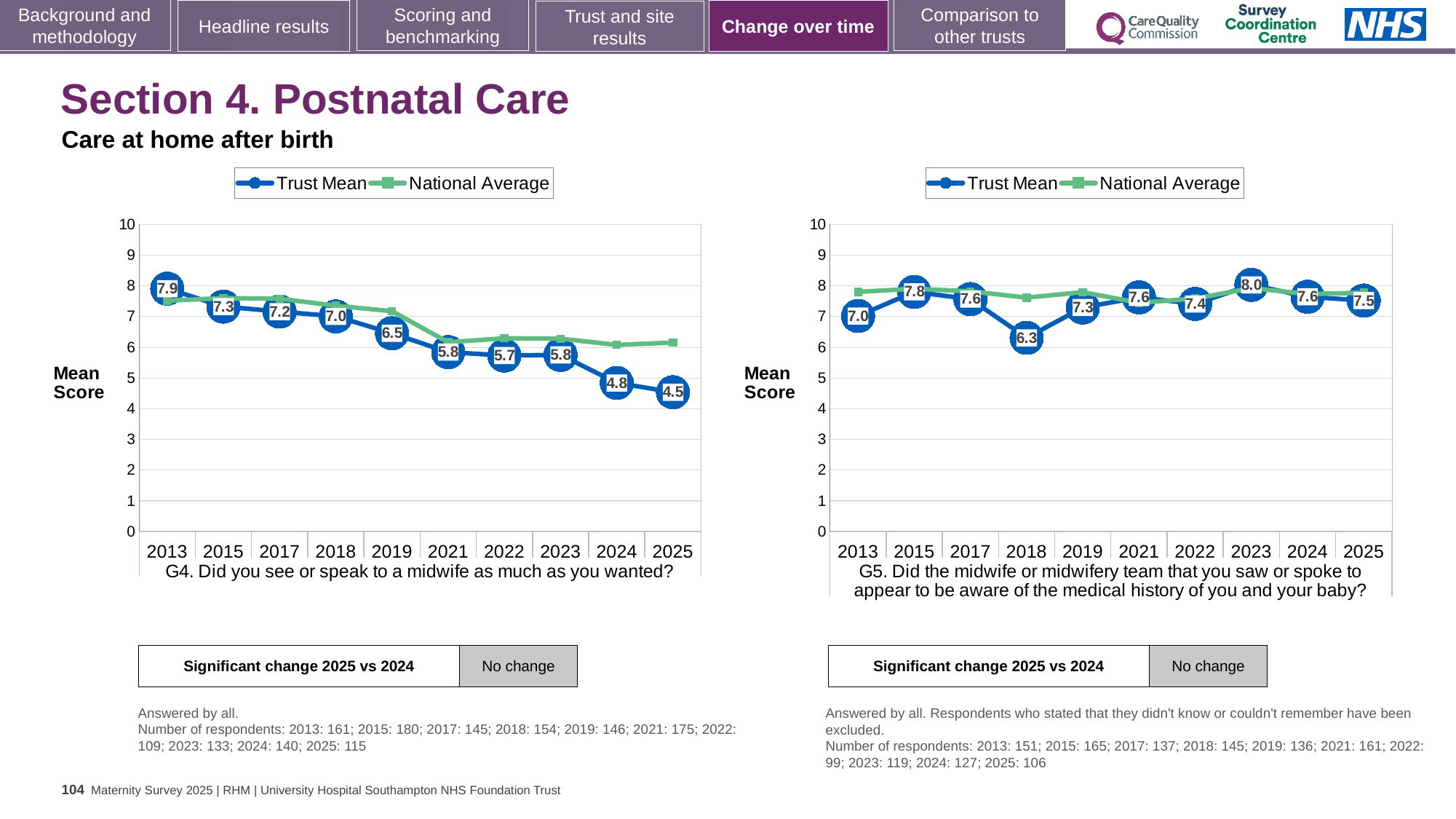
How many series does the legend of the right chart (G5) list? 2 In the left chart (G4), what is the Trust Mean score for 2013? 7.9 What kind of chart is the left chart (G4)? Line chart How many years are plotted on the x axis of the left chart (G4)? 10 In the left chart (G4), is the National Average value for 2025 greater or less than 5? greater In the left chart (G4), what is the Trust Mean score for 2025? 4.5 In the left chart (G4), which year has the lowest Trust Mean score? 2025 In the right chart (G5), which is larger: the Trust Mean score for 2015 or for 2019? 2015 In the right chart (G5), which year has the highest Trust Mean score? 2023 In the left chart (G4), what is the difference between the Trust Mean scores for 2013 and 2025? 3.4 In the right chart (G5), what is the Trust Mean score for 2018? 6.3 In the left chart (G4), does the Trust Mean score generally rise or fall from 2013 to 2025? Fall